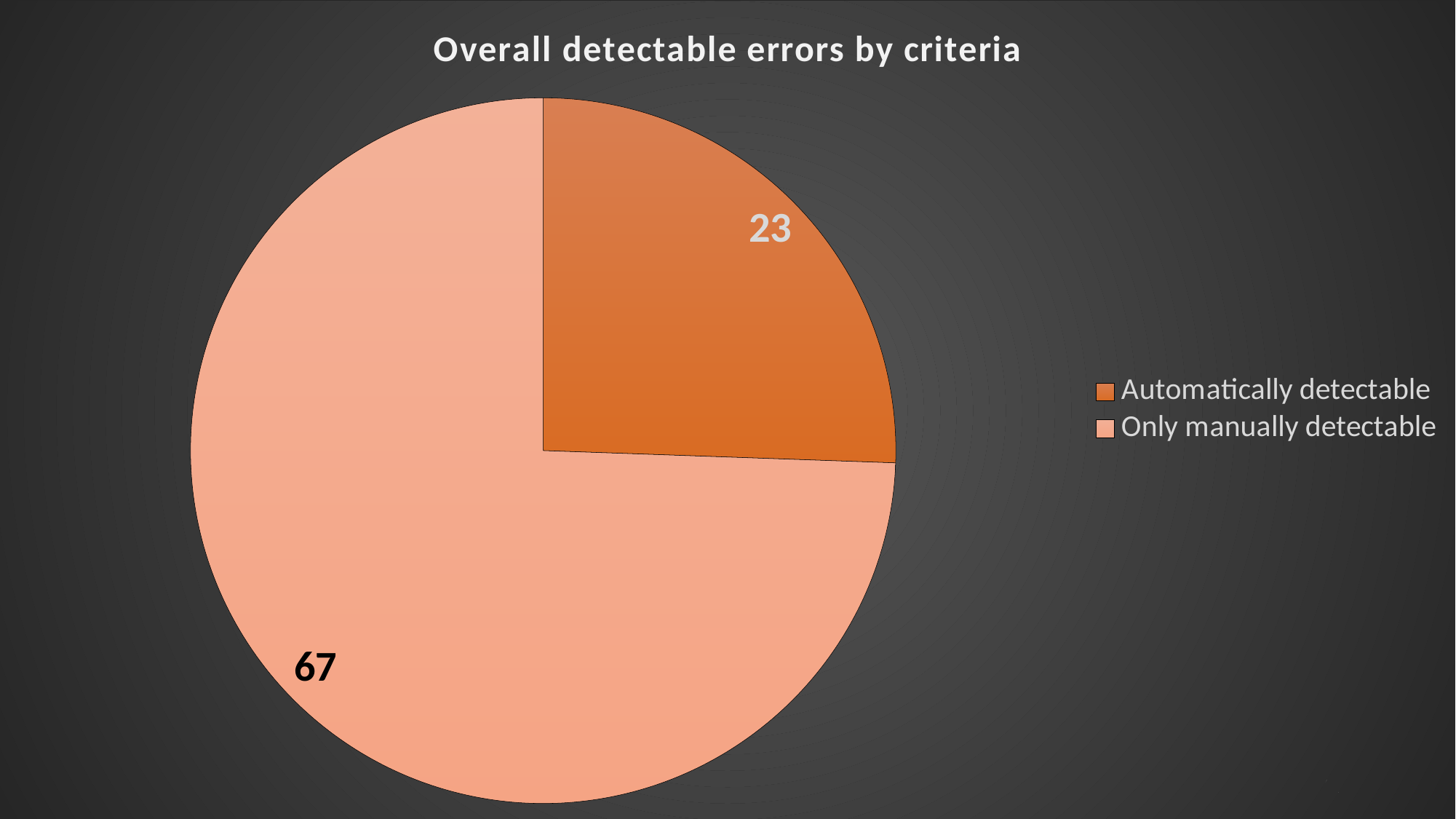
What kind of chart is shown on the slide? Pie chart Which category is shown in the darker orange colour? Automatically detectable Which category has the largest slice? Only manually detectable What is the value for Automatically detectable? 23 Which is larger, Automatically detectable or Only manually detectable? Only manually detectable What is the difference between Only manually detectable and Automatically detectable? 44 How many categories does the pie chart show? 2 What is the total of all slices in the pie chart? 90 Which category has the smallest slice? Automatically detectable What is the title of the chart? Overall detectable errors by criteria What is the value for Only manually detectable? 67